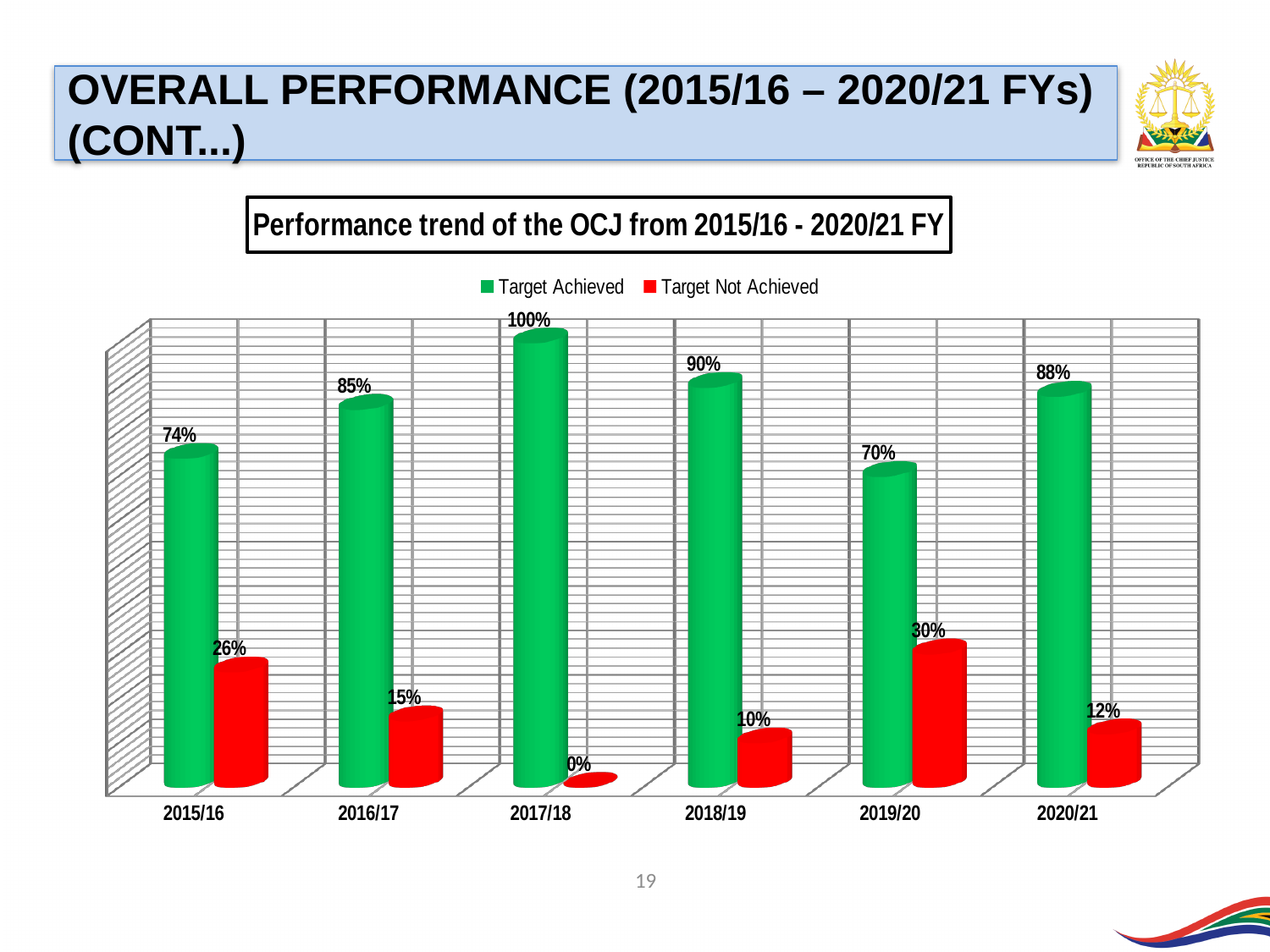
What is the Target Achieved value for 2017/18? 100% Which financial year has the lowest Target Achieved value? 2019/20 How many financial years are shown on the x axis? 6 What is the Target Achieved value for 2015/16? 74% Which is larger, the Target Achieved value for 2018/19 or for 2020/21? 2018/19 How many series does the legend list? 2 Which financial year has the highest Target Not Achieved value? 2019/20 What is the Target Not Achieved value for 2019/20? 30% What kind of chart is shown on the slide? Bar chart Which financial year has the highest Target Achieved value? 2017/18 What is the title of the chart? Performance trend of the OCJ from 2015/16 - 2020/21 FY What is the difference between the Target Achieved values for 2016/17 and 2015/16? 11%